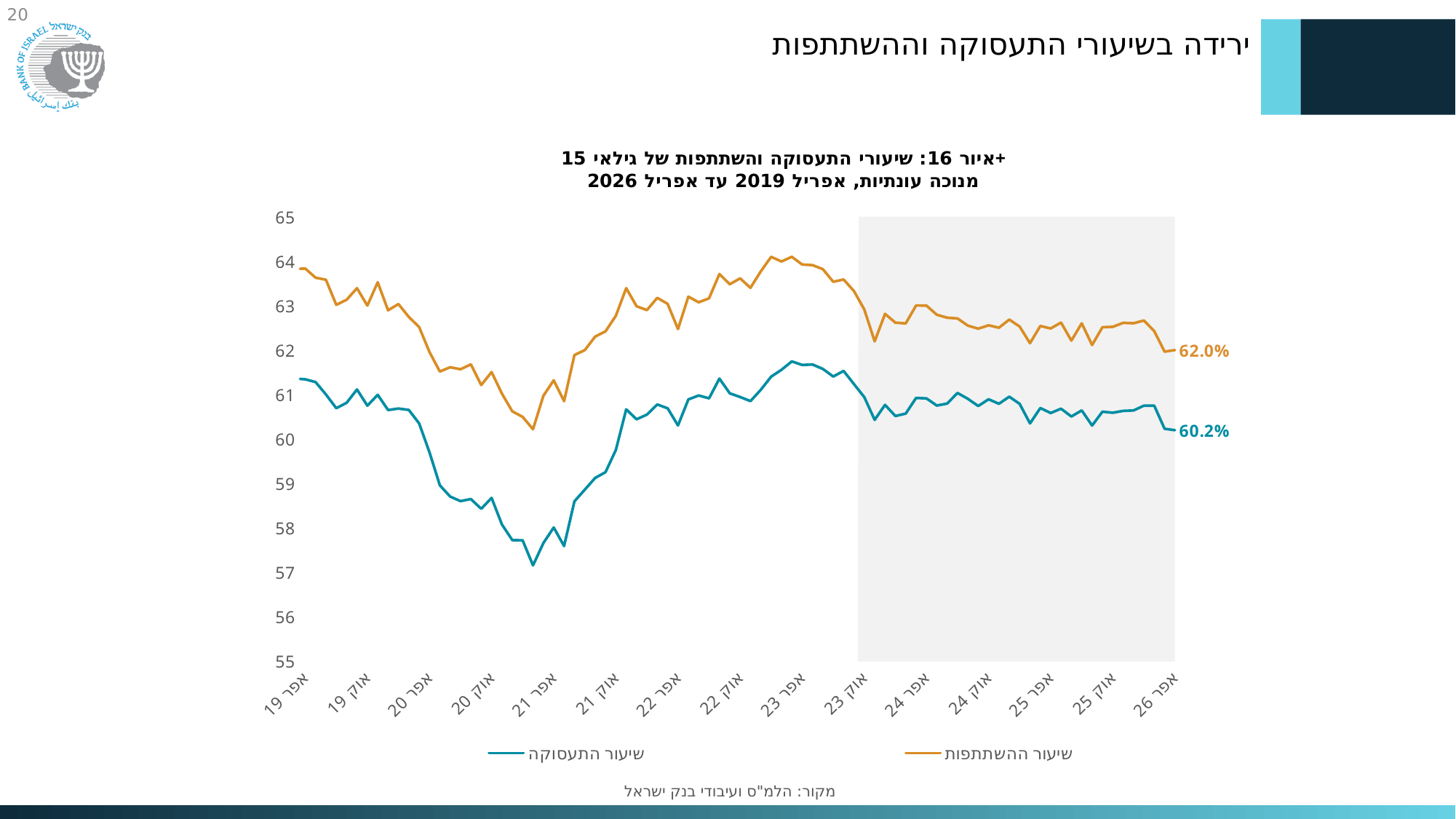
What kind of chart is shown on the slide? line chart Which series is drawn in orange? שיעור ההשתתפות Is the value of the employment rate series at אפר 19 greater or less than 60? greater At the end of the series, which is higher: the participation rate or the employment rate? the participation rate (שיעור ההשתתפות) What is the last labelled value of the employment rate (שיעור התעסוקה) series? 60.2% Does the employment rate series rise or fall between אפר 23 and אפר 26? fall Is the lowest value of the employment rate series, around אפר 21, greater or less than 58? less What is the last labelled value of the participation rate (שיעור ההשתתפות) series? 62.0% Is the value of the participation rate series at אפר 19 greater or less than 63? greater How many series does the legend list? 2 What is the difference between the final labelled participation rate and the final labelled employment rate? 1.8 percentage points What period does the chart title say the data covers? אפריל 2019 עד אפריל 2026